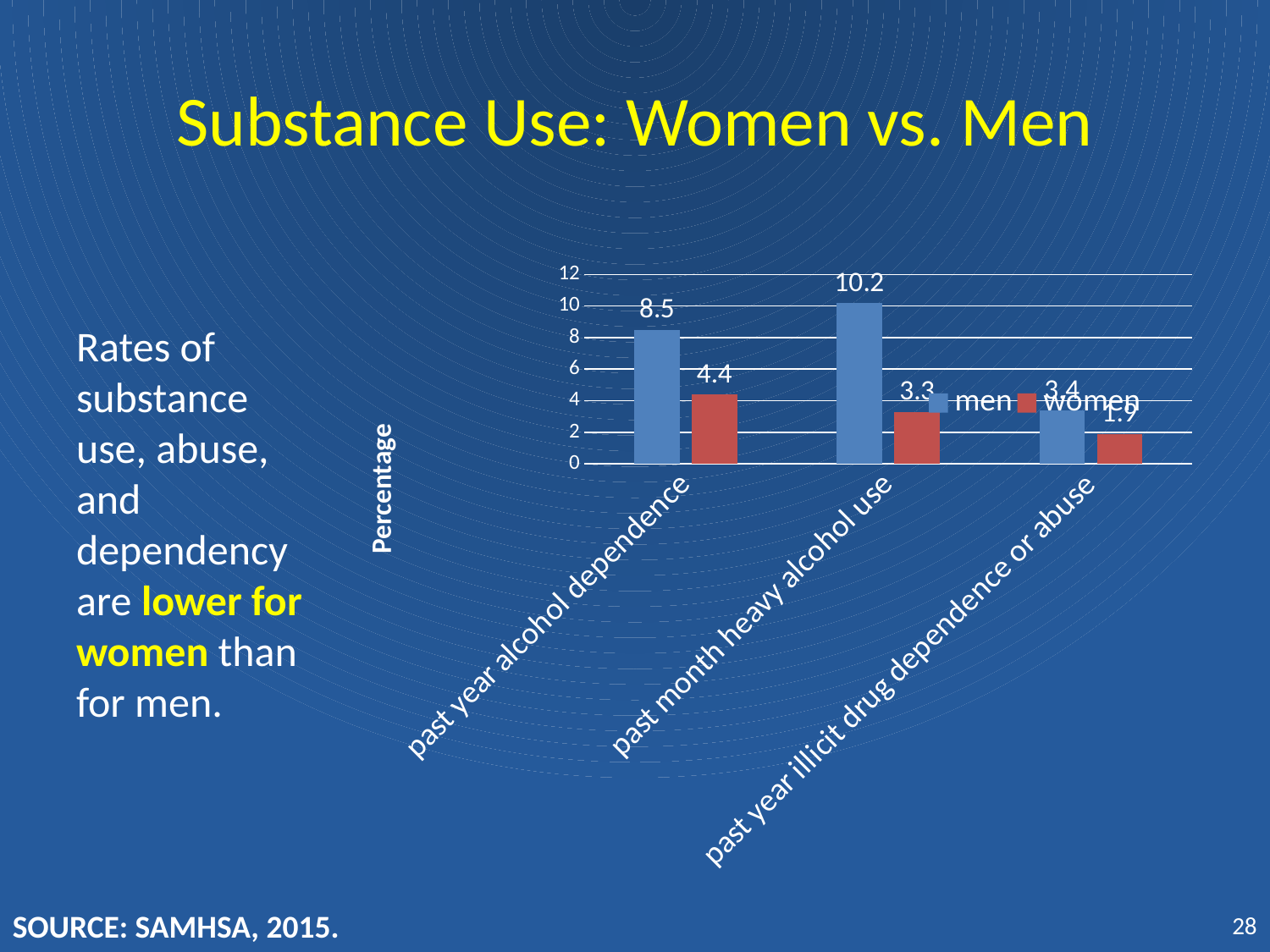
What is the value for women for past month heavy alcohol use? 3.3 What is the value for men for past year alcohol dependence? 8.5 Which category has the lowest value for women? past year illicit drug dependence or abuse Which is larger for past year alcohol dependence, the value for men or the value for women? men What kind of chart is shown on the slide? bar chart What is the value for women for past year alcohol dependence? 4.4 Which category has the highest value for men? past month heavy alcohol use Is the value for men for past month heavy alcohol use greater or less than 8? greater What is the difference between the men and women values for past month heavy alcohol use? 6.9 How many series does the legend list? 2 How many categories are shown on the x axis? 3 What is the value for men for past month heavy alcohol use? 10.2